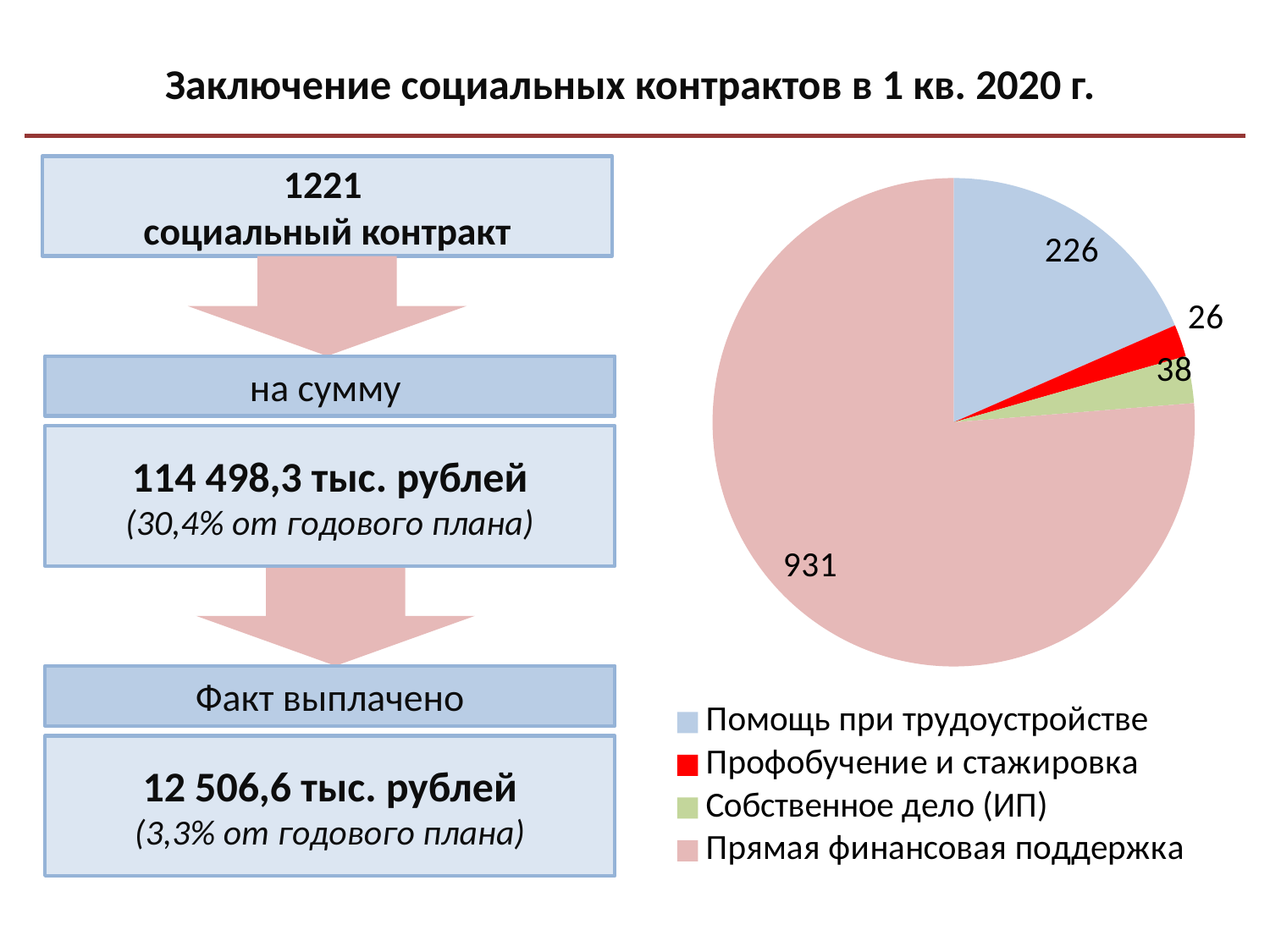
What type of chart is shown on the slide? pie chart What colour is the slice for Профобучение и стажировка in the pie chart? red How many slices does the pie chart have? 4 What is the value for Собственное дело (ИП) in the pie chart? 38 What is the value for Помощь при трудоустройстве in the pie chart? 226 Which category has the largest slice in the pie chart? Прямая финансовая поддержка What is the difference between the values for Прямая финансовая поддержка and Помощь при трудоустройстве? 705 How many entries does the legend of the pie chart list? 4 What is the value for Прямая финансовая поддержка in the pie chart? 931 What is the value for Профобучение и стажировка in the pie chart? 26 Which category has the smallest slice in the pie chart? Профобучение и стажировка Which is larger in the pie chart: Собственное дело (ИП) or Профобучение и стажировка? Собственное дело (ИП)